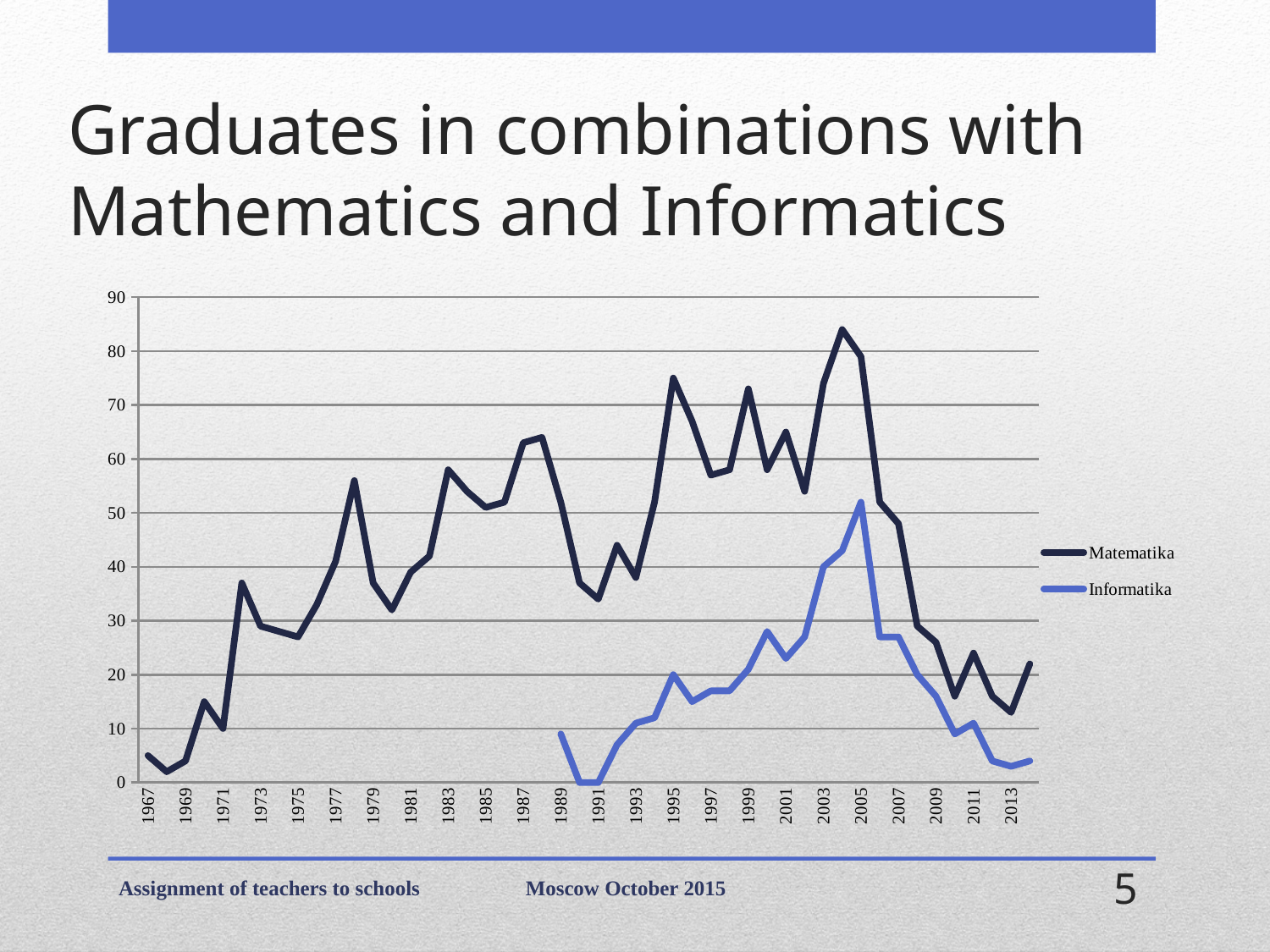
How many series does the legend list? 2 Which series reaches the higher peak value over the whole period? Matematika What are the two series named in the legend? Matematika and Informatika In which year does the Informatika series reach its highest value? 2005 Which series has the larger value in 2005, Matematika or Informatika? Matematika Is the value for Informatika in 2013 greater or less than 10? less Does the Informatika series rise or fall between 1991 and 2005? rise Is the peak value of Matematika (around 2004) greater or less than 80? greater Does the Matematika series rise or fall between 2005 and 2009? fall What kind of chart is shown on the slide? line chart Is the value for Informatika in 2005 greater or less than 40? greater